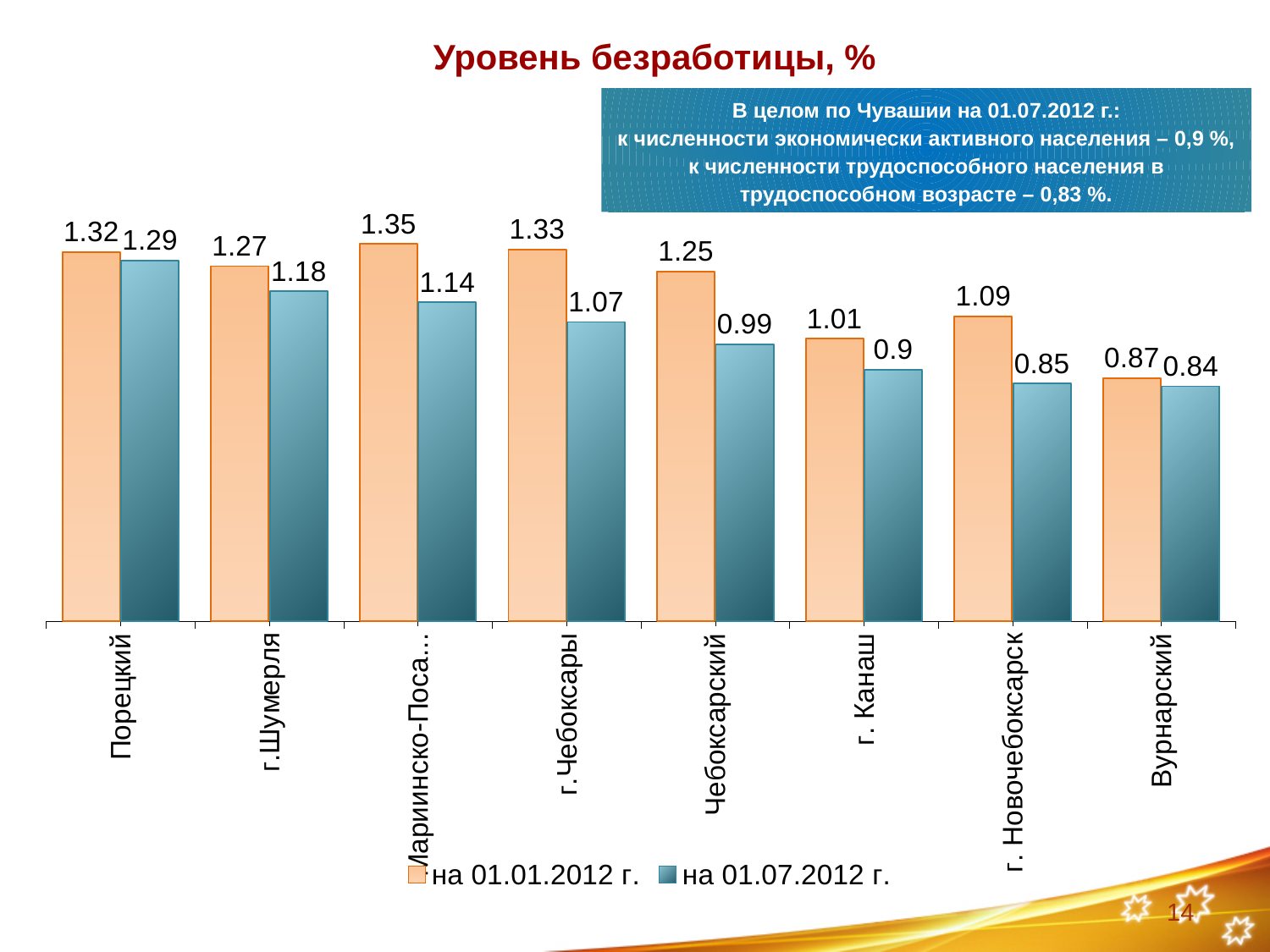
Which category has the highest value for на 01.07.2012 г.? Порецкий What is the value for г. Канаш на 01.07.2012 г.? 0.9 Which is larger: the на 01.07.2012 г. value for г.Шумерля or for г.Чебоксары? г.Шумерля Which category has the lowest value for на 01.01.2012 г.? Вурнарский What is the title of the chart? Уровень безработицы, % What is the value for г.Чебоксары на 01.07.2012 г.? 1.07 What is the difference between the на 01.01.2012 г. and на 01.07.2012 г. values for Чебоксарский? 0.26 What kind of chart is shown on the slide? Bar chart How many categories are shown on the x axis? 8 How many series does the legend list? 2 What is the value for г. Новочебоксарск на 01.01.2012 г.? 1.09 What is the unemployment rate for Порецкий на 01.01.2012 г.? 1.32